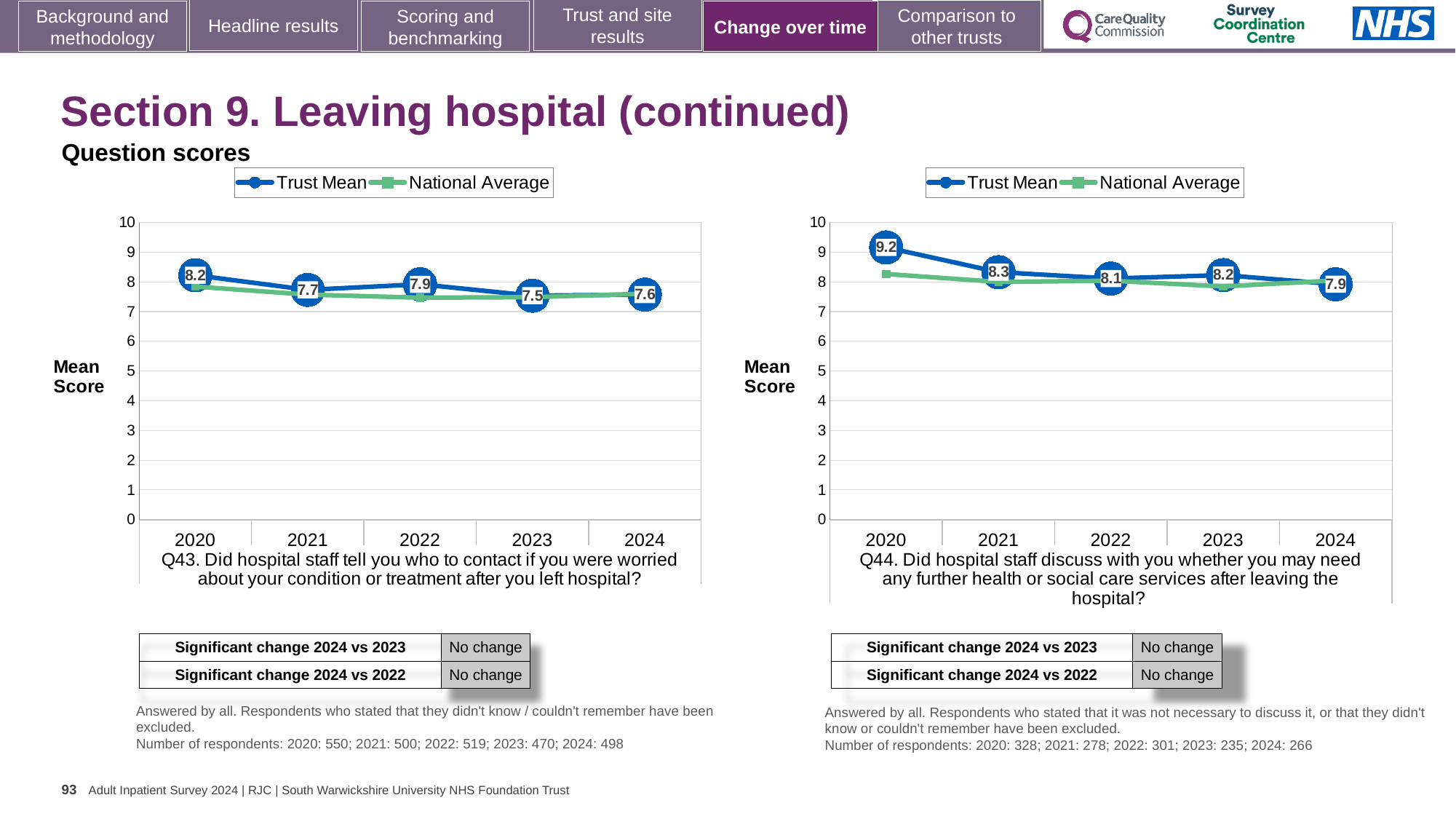
On the Q43 chart (left), what is the Trust Mean score for 2024? 7.6 What kind of chart is the Q43 chart (left)? Line chart On the Q43 chart (left), which year has the lowest Trust Mean score? 2023 On the Q44 chart (right), what is the Trust Mean score for 2020? 9.2 How many series does the legend of the Q44 chart (right) list? 2 On the Q43 chart (left), what is the Trust Mean score for 2020? 8.2 On the Q44 chart (right), which year has the highest Trust Mean score? 2020 How many years are plotted on the Q43 chart (left)? 5 On the Q44 chart (right), is the National Average for 2020 greater or less than 9? less On the Q44 chart (right), what is the difference between the Trust Mean scores for 2020 and 2024? 1.3 On the Q43 chart (left), which is larger, the Trust Mean score for 2021 or for 2022? 2022 On the Q44 chart (right), what is the Trust Mean score for 2022? 8.1